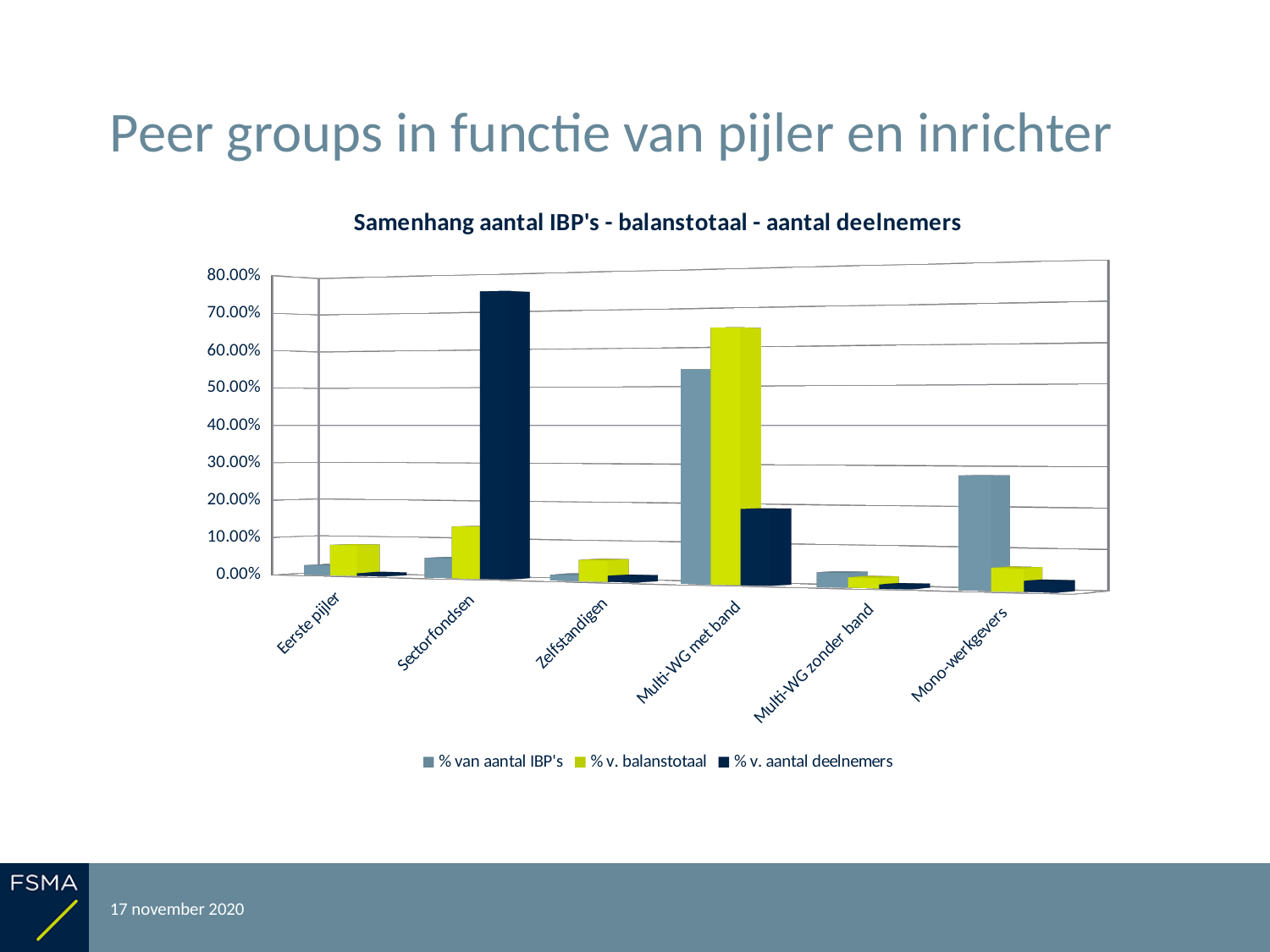
What kind of chart is shown on the slide? Bar chart Is the value for % v. balanstotaal for Multi-WG met band greater or less than 60.00%? greater Is the value for % v. aantal deelnemers for Sectorfondsen greater or less than 70.00%? greater Which series is shown in dark navy bars in the chart? % v. aantal deelnemers Which category has the highest value for % v. balanstotaal? Multi-WG met band How many series does the chart's legend list? 3 Which category has the highest value for % van aantal IBP's? Multi-WG met band Is the value for % van aantal IBP's for Mono-werkgevers greater or less than 20.00%? greater How many categories are shown along the x axis of the chart? 6 Which category has the highest value for % v. aantal deelnemers? Sectorfondsen What is the title of the chart? Samenhang aantal IBP's - balanstotaal - aantal deelnemers For Multi-WG met band, which is larger: % van aantal IBP's or % v. balanstotaal? % v. balanstotaal